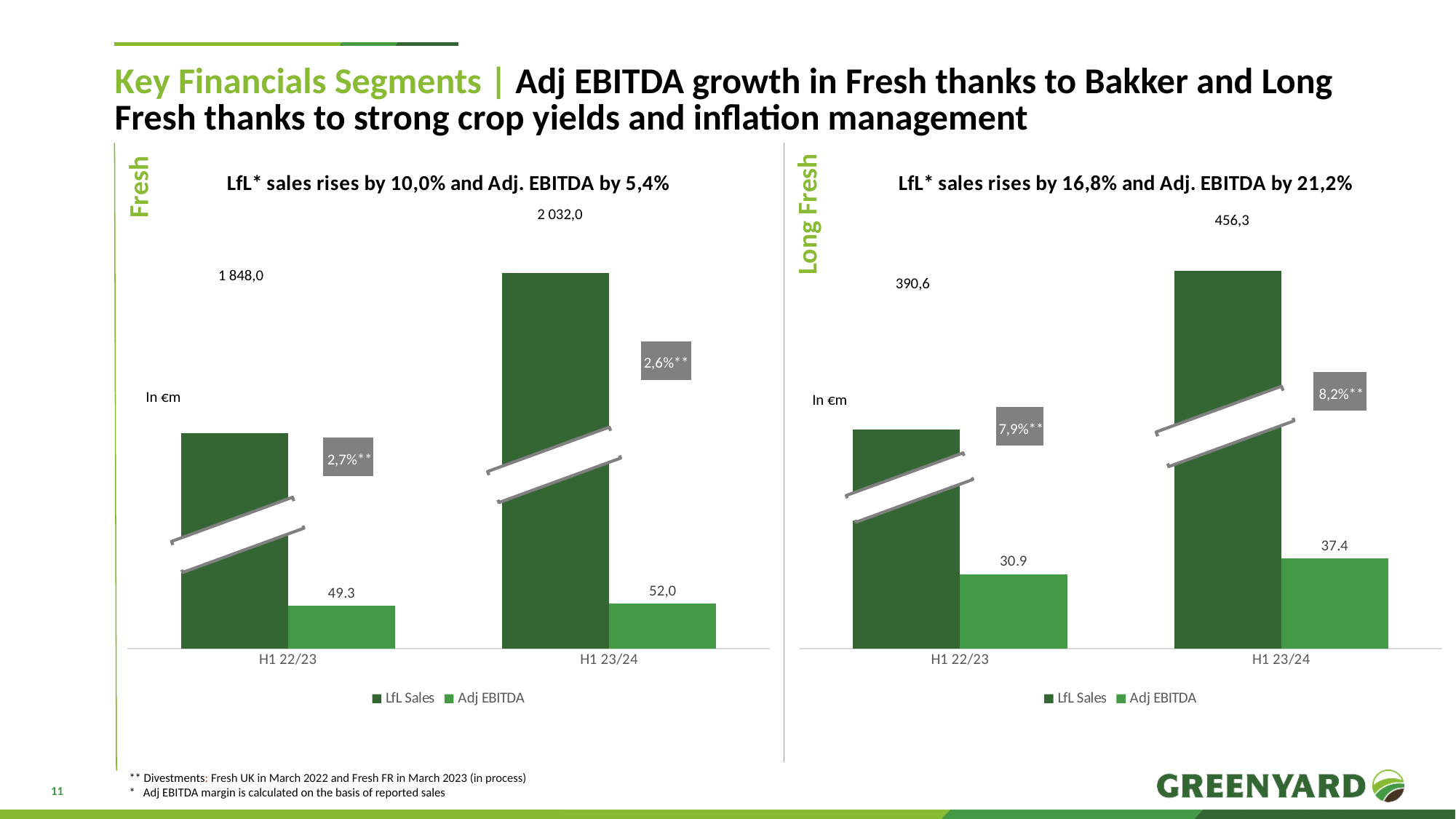
How many series does the legend of the Long Fresh chart list? 2 In the Fresh chart, what is the LfL Sales value for H1 23/24? 2 032,0 In the Fresh chart, does Adj EBITDA rise or fall from H1 22/23 to H1 23/24? rise In the Long Fresh chart, what Adj EBITDA margin is shown for H1 23/24? 8,2% In the Long Fresh chart, what is the LfL Sales value for H1 22/23? 390,6 In the Fresh chart, by how much did LfL Sales increase from H1 22/23 to H1 23/24? 184,0 In the Long Fresh chart, which period has the higher LfL Sales, H1 22/23 or H1 23/24? H1 23/24 What type of chart is used for the Fresh segment? bar chart In the Fresh chart, what is the Adj EBITDA value for H1 22/23? 49.3 How many periods are shown on the x axis of the Fresh chart? 2 In the Long Fresh chart, what is the difference in Adj EBITDA between H1 23/24 and H1 22/23? 6.5 In the Long Fresh chart, what is the Adj EBITDA value for H1 23/24? 37.4